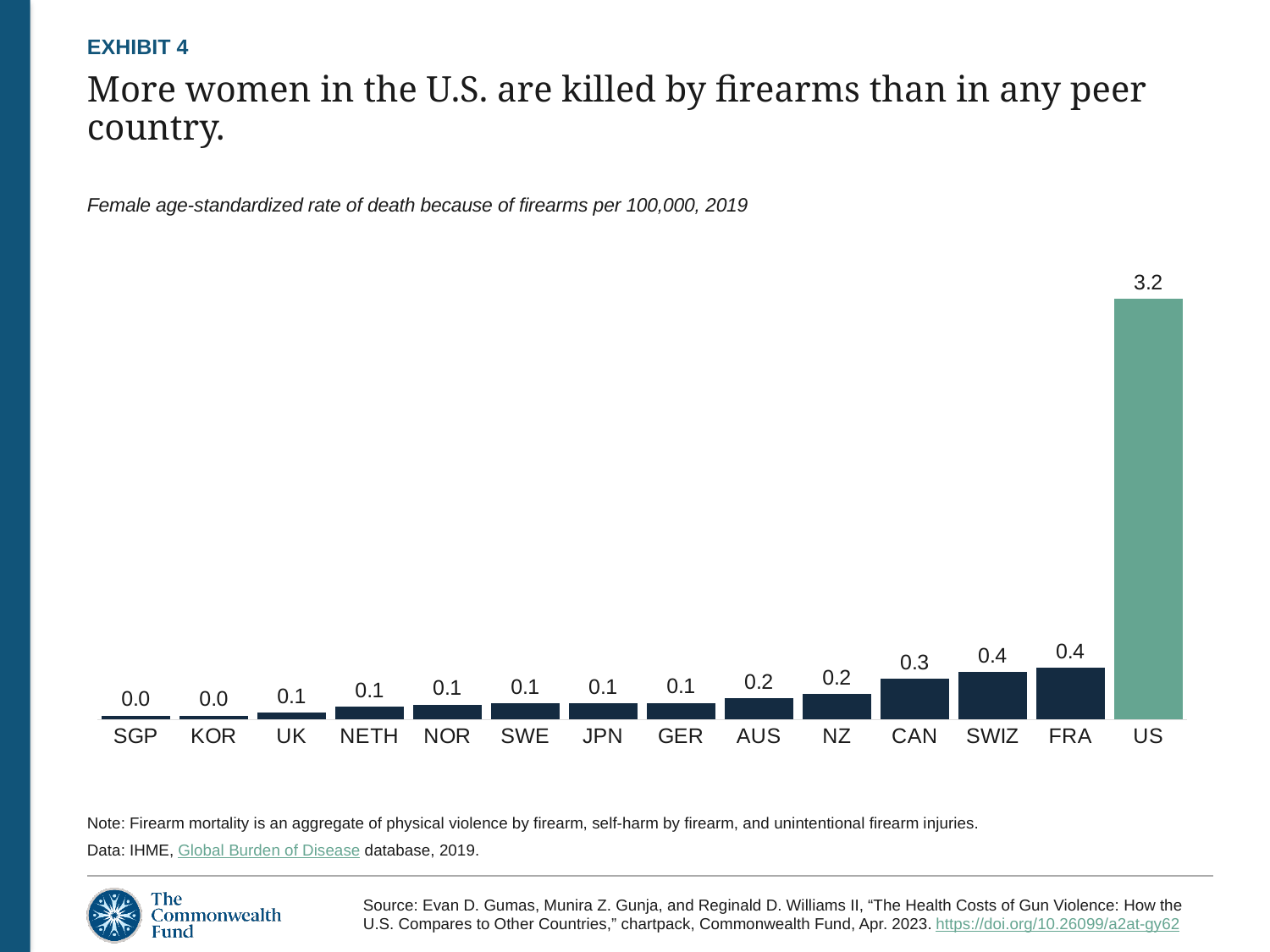
What is the difference between the values for the US and FRA? 2.8 Do the values generally rise or fall moving from left to right along the x axis? Rise How many countries are shown on the chart? 14 What is the difference between the values for SWIZ and CAN? 0.1 What is the value shown for CAN? 0.3 What is the value shown for AUS? 0.2 What is the value shown for SGP? 0.0 Which country has the highest female firearm death rate on the chart? US What kind of chart is shown on the slide? Bar chart What is the female firearm death rate per 100,000 for the US? 3.2 Which bar is shown in a different colour from the others? US Which is larger, the value for CAN or the value for NZ? CAN